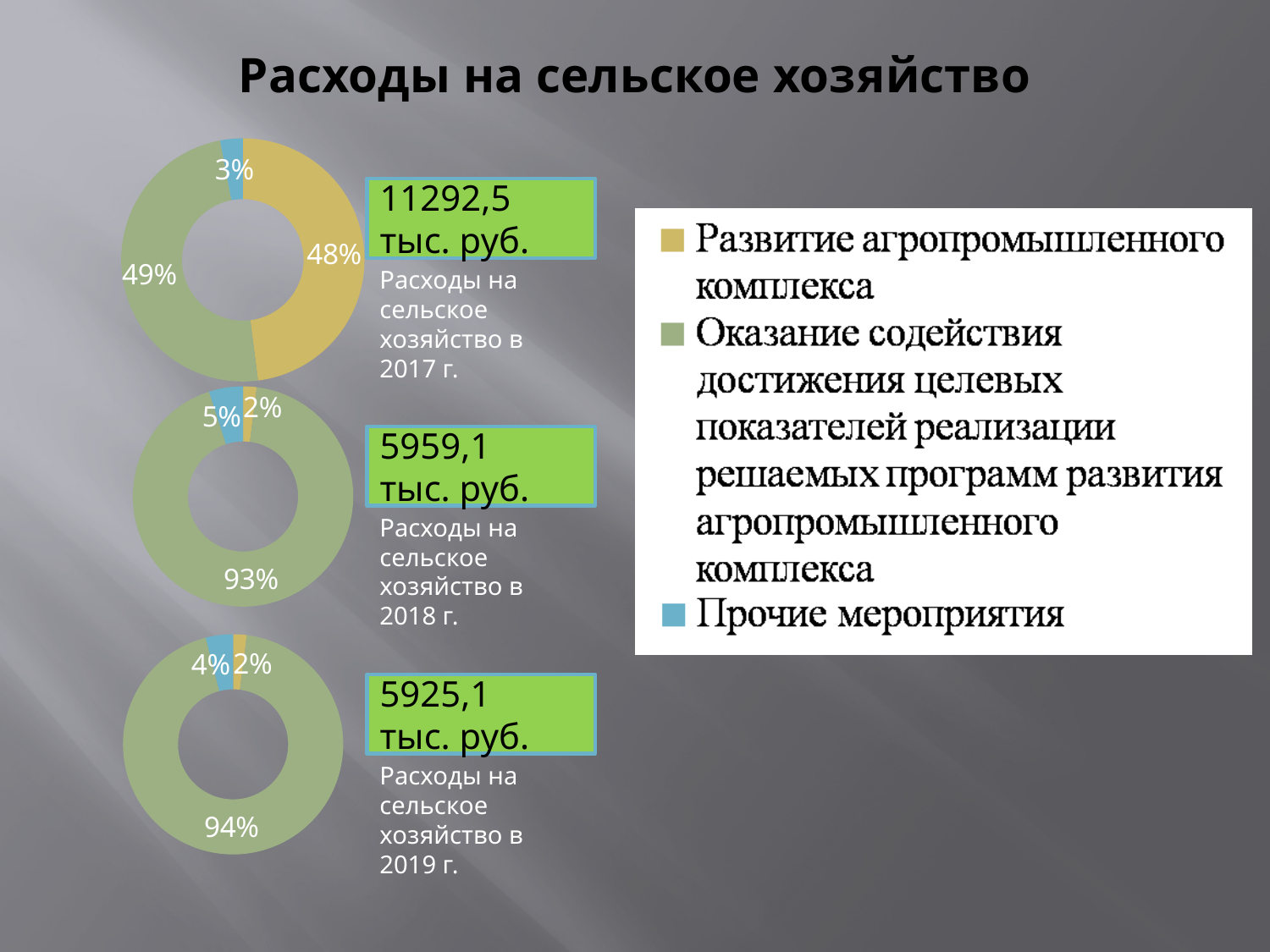
What total expenditure amount is shown next to the 2017 chart (top)? 11292,5 тыс. руб. In the 2017 chart (top), what share is labelled for the yellow slice (Развитие агропромышленного комплекса)? 48% In the 2019 chart (bottom), what share is labelled for the green slice? 94% In the 2018 chart (middle), what share is labelled for the green slice? 93% How many categories does the legend list for the charts? 3 In the 2019 chart (bottom), which category has the smallest share? Развитие агропромышленного комплекса In the 2018 chart (middle), which category has the largest share? Оказание содействия достижения целевых показателей реализации решаемых программ развития агропромышленного комплекса What is the difference between the green slice share in the 2019 chart (94%) and the green slice share in the 2018 chart (93%)? 1% What kind of chart is used for the 2017 agricultural expenditure data (top chart)? doughnut chart